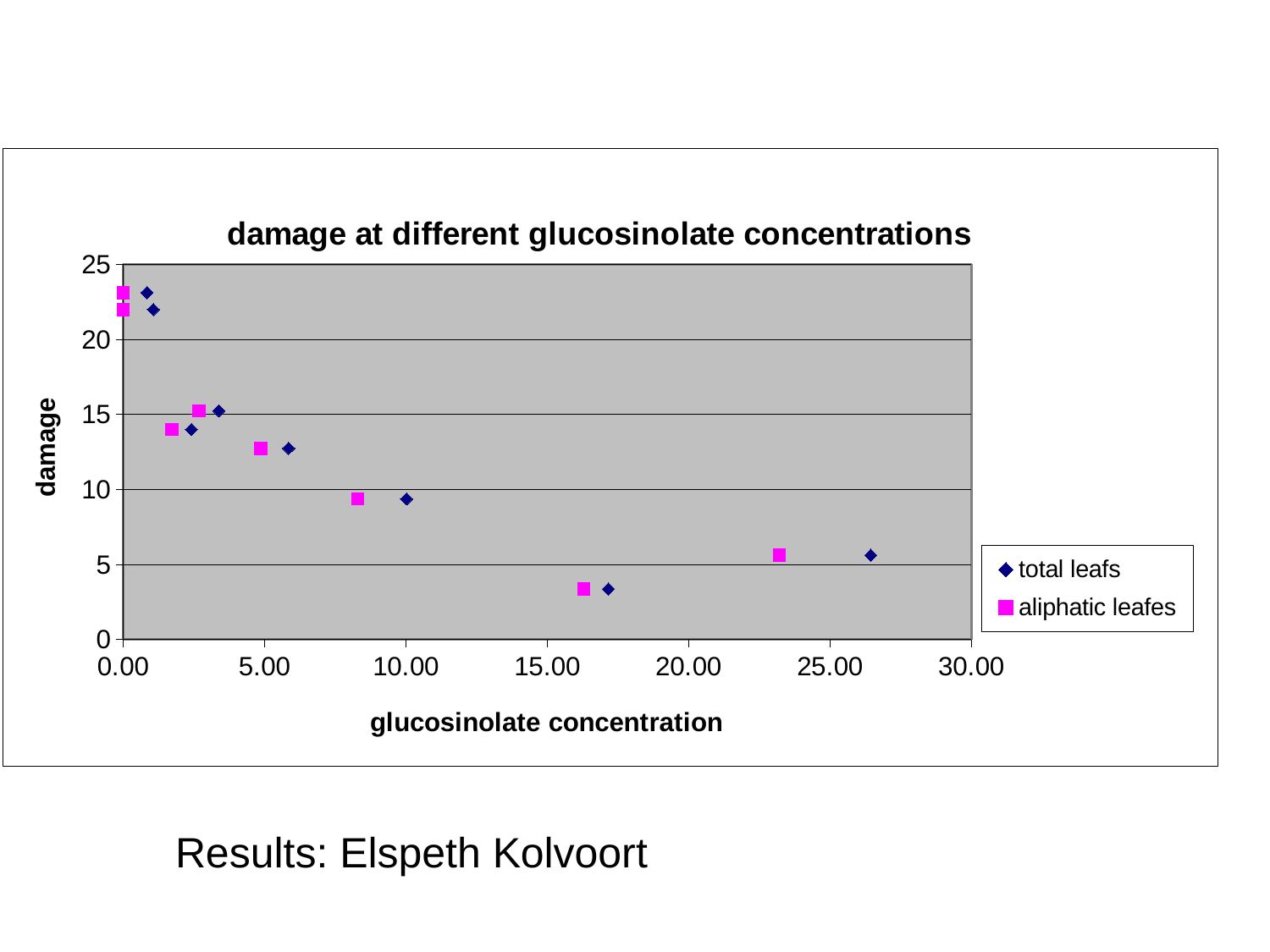
Which series reaches the higher glucosinolate concentration on the x axis, total leafs or aliphatic leafes? total leafs Is the lowest damage value plotted for the aliphatic leafes series greater or less than 5? less How many data points are plotted for the total leafs series? 8 What is the title of the chart? damage at different glucosinolate concentrations What is the highest value shown on the x axis? 30.00 Is the largest glucosinolate concentration plotted for the total leafs series greater or less than 25.00? greater Is the highest damage value plotted for the total leafs series greater or less than 20? greater What kind of chart is shown on the slide? scatter chart What is the label of the y axis? damage How many series does the legend list? 2 As glucosinolate concentration increases along the x axis, does damage generally rise or fall? fall